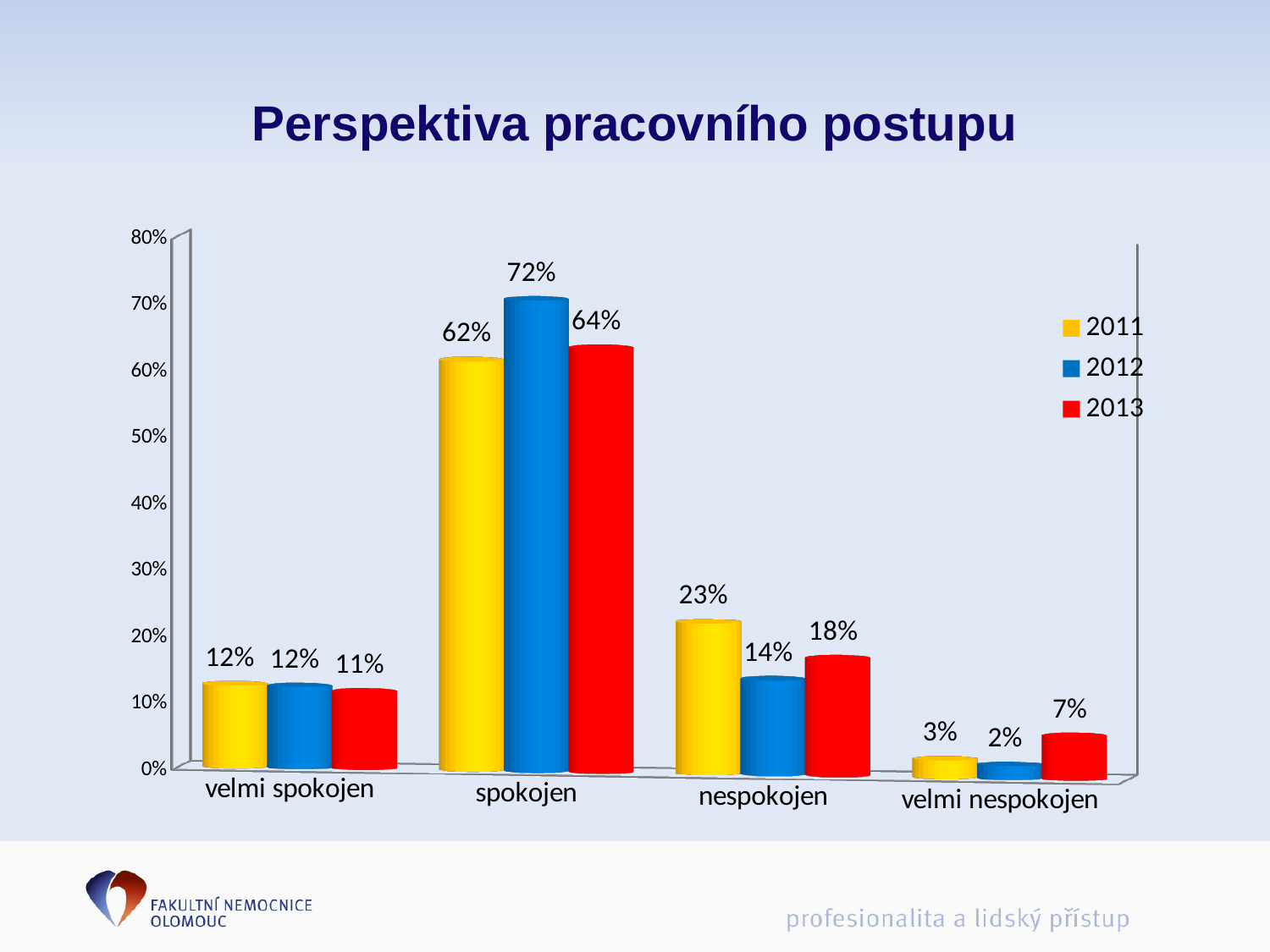
What kind of chart is shown on the slide? bar chart Which colour represents the 2013 series? red Which category has the lowest value in 2012? velmi nespokojen What is the difference between the 2012 and 2011 values for 'spokojen'? 10% What is the value for 'velmi nespokojen' in 2013? 7% Which category has the highest value in 2013? spokojen What is the title of the slide? Perspektiva pracovního postupu What is the value for 'spokojen' in 2012? 72% How many categories are shown on the x axis? 4 How many series does the legend list? 3 Which is larger for 'nespokojen': the 2011 value or the 2013 value? 2011 What is the value for 'nespokojen' in 2011? 23%